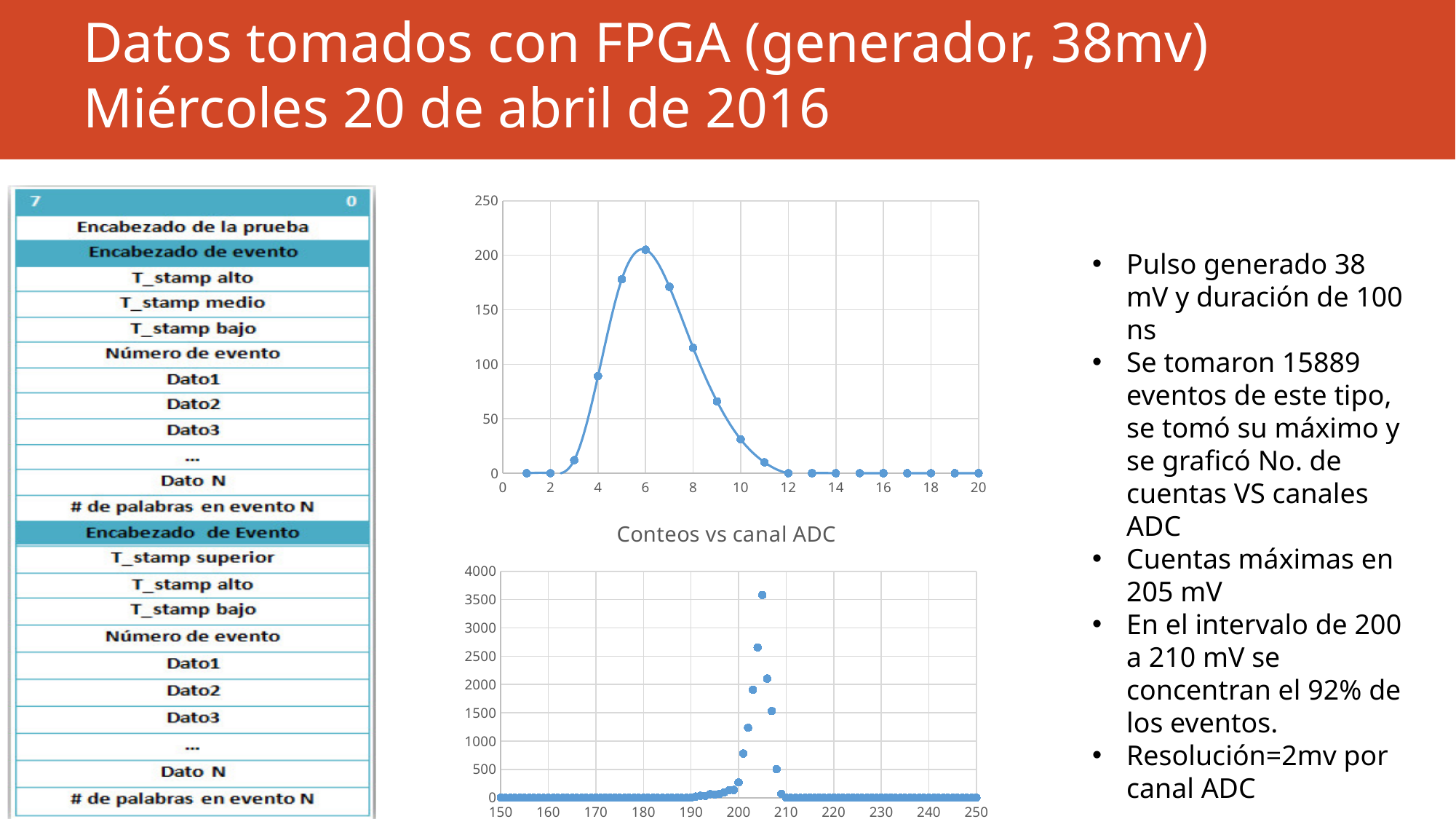
What is the highest value shown on the y axis of the 'Conteos vs canal ADC' chart? 4000 In the upper chart (x axis 0 to 20), is the value at x = 8 greater or less than 100? greater In the upper chart (x axis 0 to 20), is the value at x = 4 greater or less than 100? less In the upper chart (x axis 0 to 20), which is larger, the value at x = 5 or the value at x = 9? x = 5 In the 'Conteos vs canal ADC' chart, is the highest point greater or less than 3000? greater What is the title of the lower chart on the slide? Conteos vs canal ADC What kind of chart is 'Conteos vs canal ADC'? scatter chart In the upper chart (x axis 0 to 20), at which x value does the curve reach its highest point? 6 In the upper chart (x axis 0 to 20), do the values rise or fall between x = 6 and x = 12? fall